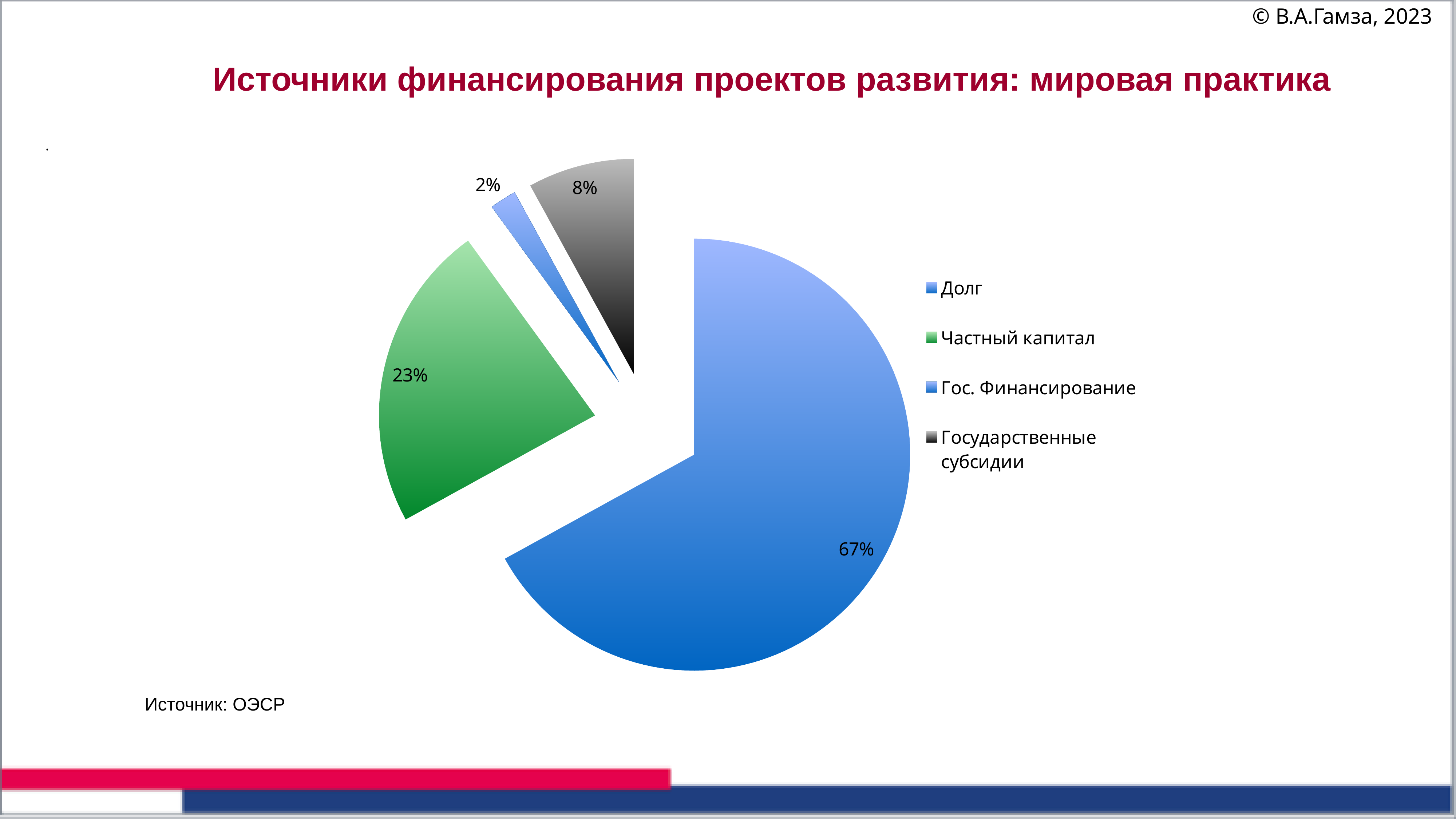
What kind of chart is shown on the slide? Pie chart How many slices does the pie chart have? 4 Which category has the largest slice of the pie? Долг What share of the pie does Государственные субсидии account for? 8% What share of the pie does Долг account for? 67% How many entries does the legend list? 4 What colour is the slice for Частный капитал? Green What share of the pie does Частный капитал account for? 23% What share of the pie does Гос. Финансирование account for? 2% What is the difference in percentage points between Долг and Частный капитал? 44 Which category has the smallest slice of the pie? Гос. Финансирование Which is larger: the slice for Государственные субсидии or the slice for Гос. Финансирование? Государственные субсидии